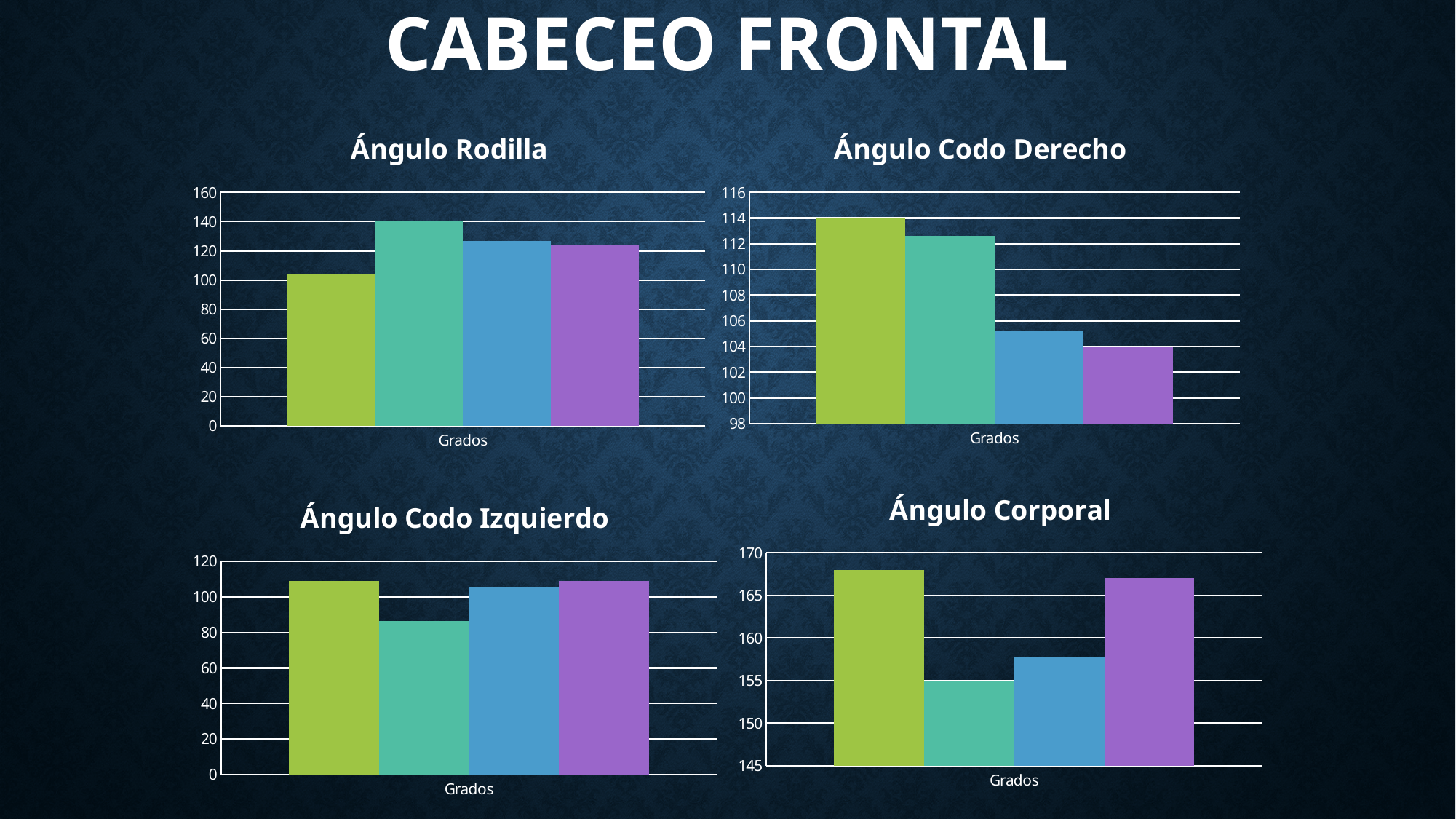
What is the x-axis label shown under each of the four charts? Grados In the Ángulo Codo Derecho chart, do the bar values rise or fall from left to right? fall In the Ángulo Codo Izquierdo chart, which coloured bar is the lowest? the teal bar In the Ángulo Corporal chart, is the green bar greater or less than 165? greater In the Ángulo Corporal chart, which coloured bar is the lowest? the teal bar In the Ángulo Rodilla chart, is the green bar greater or less than 100? greater In the Ángulo Codo Izquierdo chart, is the teal bar greater or less than 100? less In the Ángulo Rodilla chart, which coloured bar is the highest? the teal bar In the Ángulo Rodilla chart, which coloured bar is the lowest? the green bar How many bars are plotted in the Ángulo Codo Derecho chart? 4 In the Ángulo Codo Derecho chart, which coloured bar is the highest? the green bar What kind of chart is the Ángulo Rodilla chart? bar chart